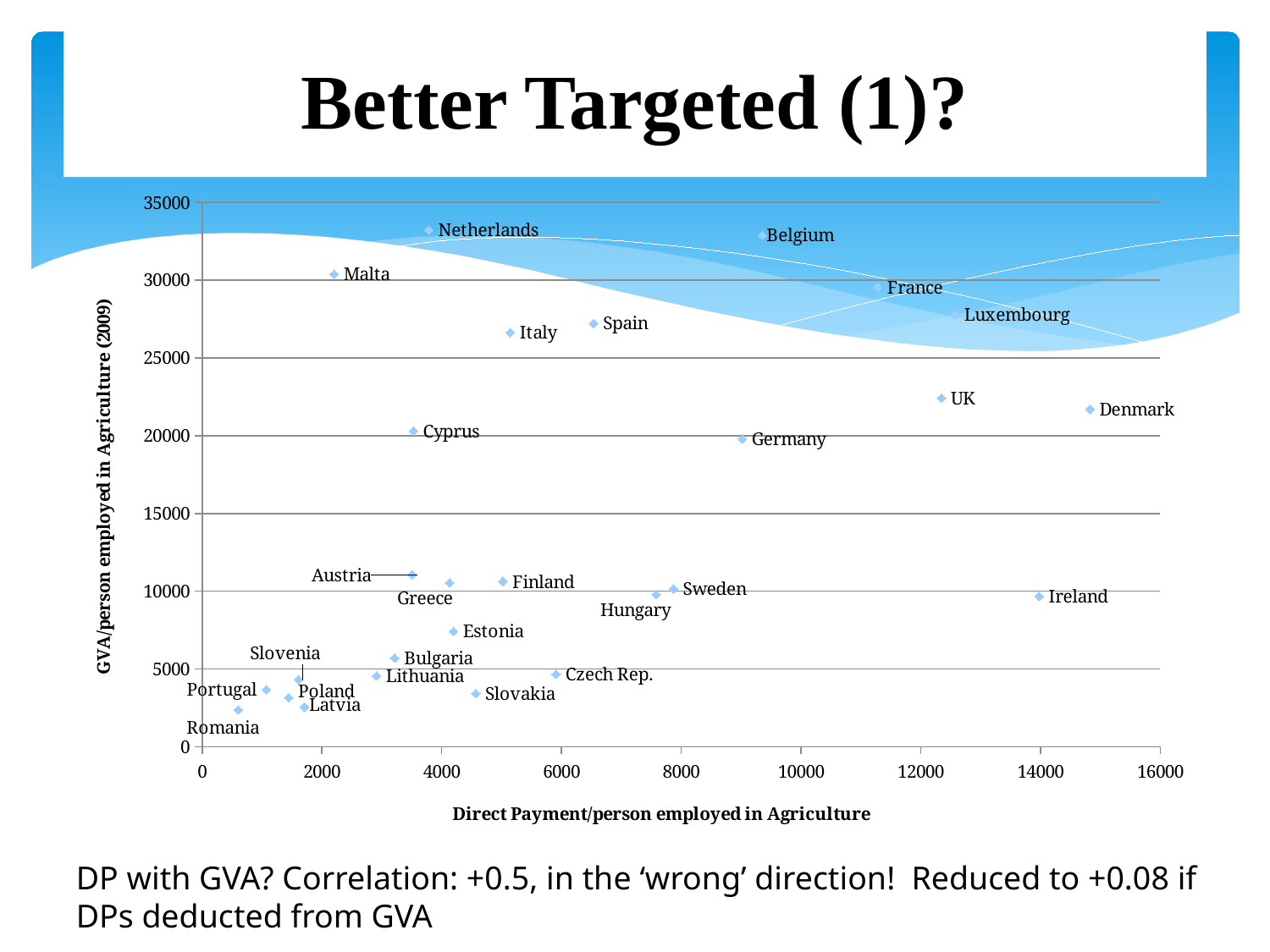
What is the title of the x axis of the chart? Direct Payment/person employed in Agriculture What kind of chart is shown on the slide? scatter chart Which country has the lowest Direct Payment per person employed in Agriculture? Romania Which country has the higher GVA/person employed in Agriculture, Germany or Ireland? Germany Is the GVA/person employed in Agriculture for Malta greater or less than 25000? greater Is the GVA/person employed in Agriculture for Ireland greater or less than 15000? less Is the Direct Payment/person employed in Agriculture for Germany greater or less than 8000? greater Which country has the highest Direct Payment per person employed in Agriculture? Denmark How many countries are plotted on the chart? 27 Which country has the higher Direct Payment per person employed in Agriculture, Luxembourg or France? Luxembourg